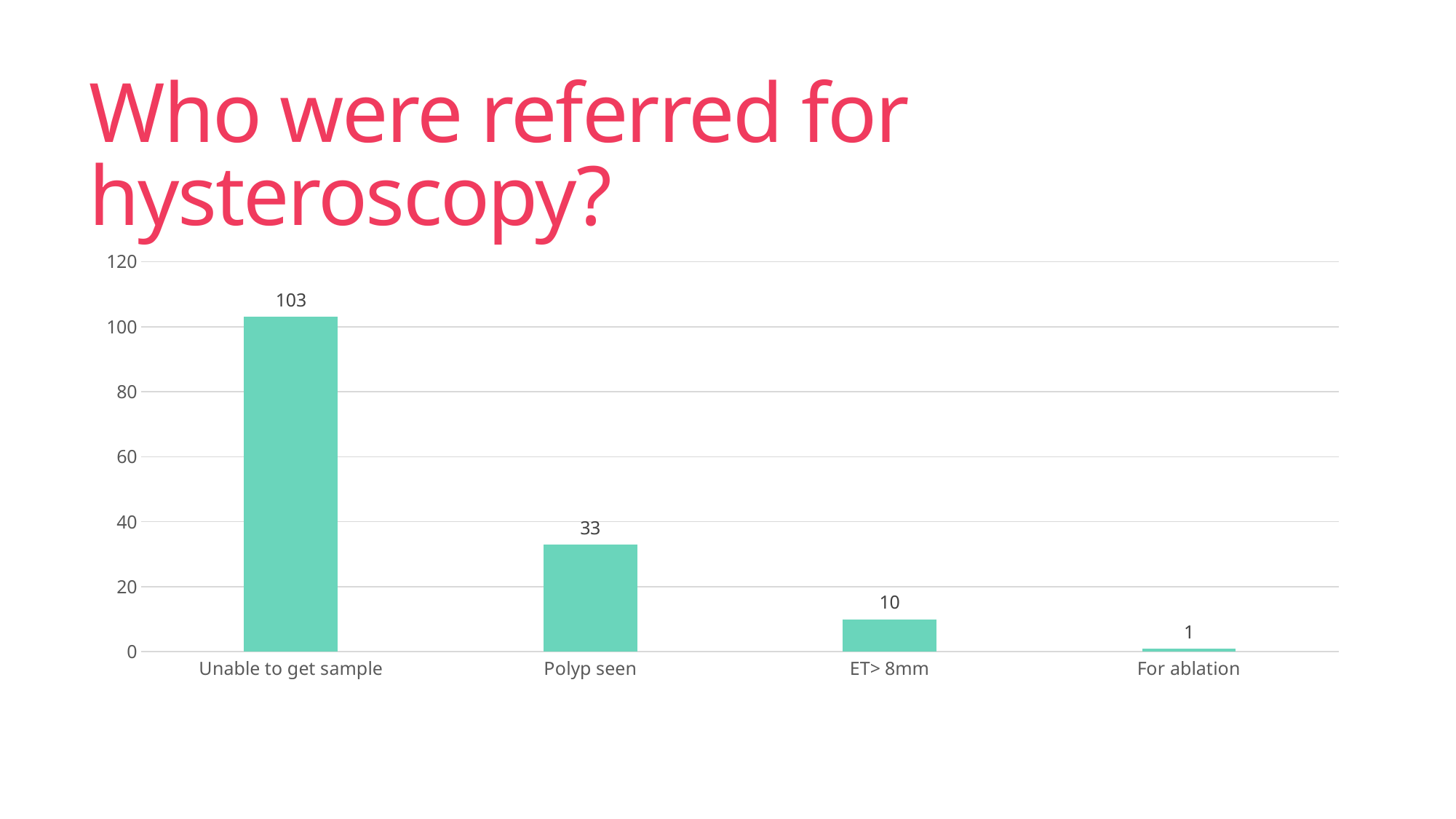
What is the value for For ablation? 1 What is the value for Polyp seen? 33 What is the value for Unable to get sample? 103 Which category has the highest value? Unable to get sample What is the difference between the values for Unable to get sample and Polyp seen? 70 How many categories are shown on the x axis? 4 What is the value for ET> 8mm? 10 What is the difference between the values for Polyp seen and ET> 8mm? 23 Which category has the lowest value? For ablation Which is larger, the value for Polyp seen or the value for ET> 8mm? Polyp seen What kind of chart is shown on the slide? bar chart Is the value for Unable to get sample greater or less than 100? greater